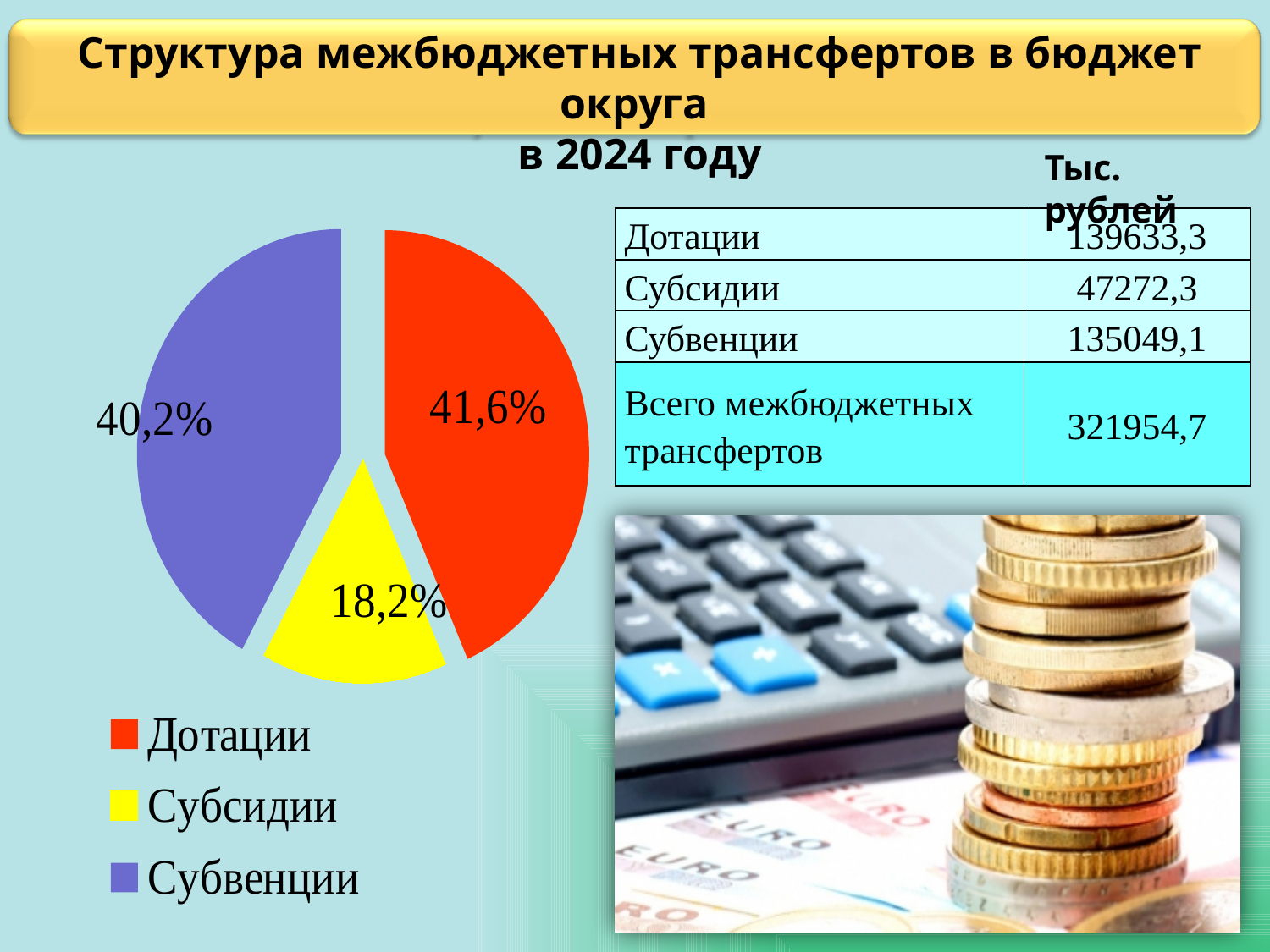
What is the difference in percentage points between the Дотации slice and the Субвенции slice? 1,4 How many slices does the pie chart have? 3 Which category has the smallest slice in the pie chart? Субсидии Which category has the largest slice in the pie chart? Дотации What share of the pie chart does Дотации represent? 41,6% What share of the pie chart does Субсидии represent? 18,2% What is the difference in percentage points between the Дотации slice and the Субсидии slice? 23,4 How many entries does the chart legend list? 3 What type of chart is shown on the slide? Pie chart Which slice is larger, Субвенции or Субсидии? Субвенции What share of the pie chart does Субвенции represent? 40,2% What colour is the Субсидии slice in the pie chart? Yellow